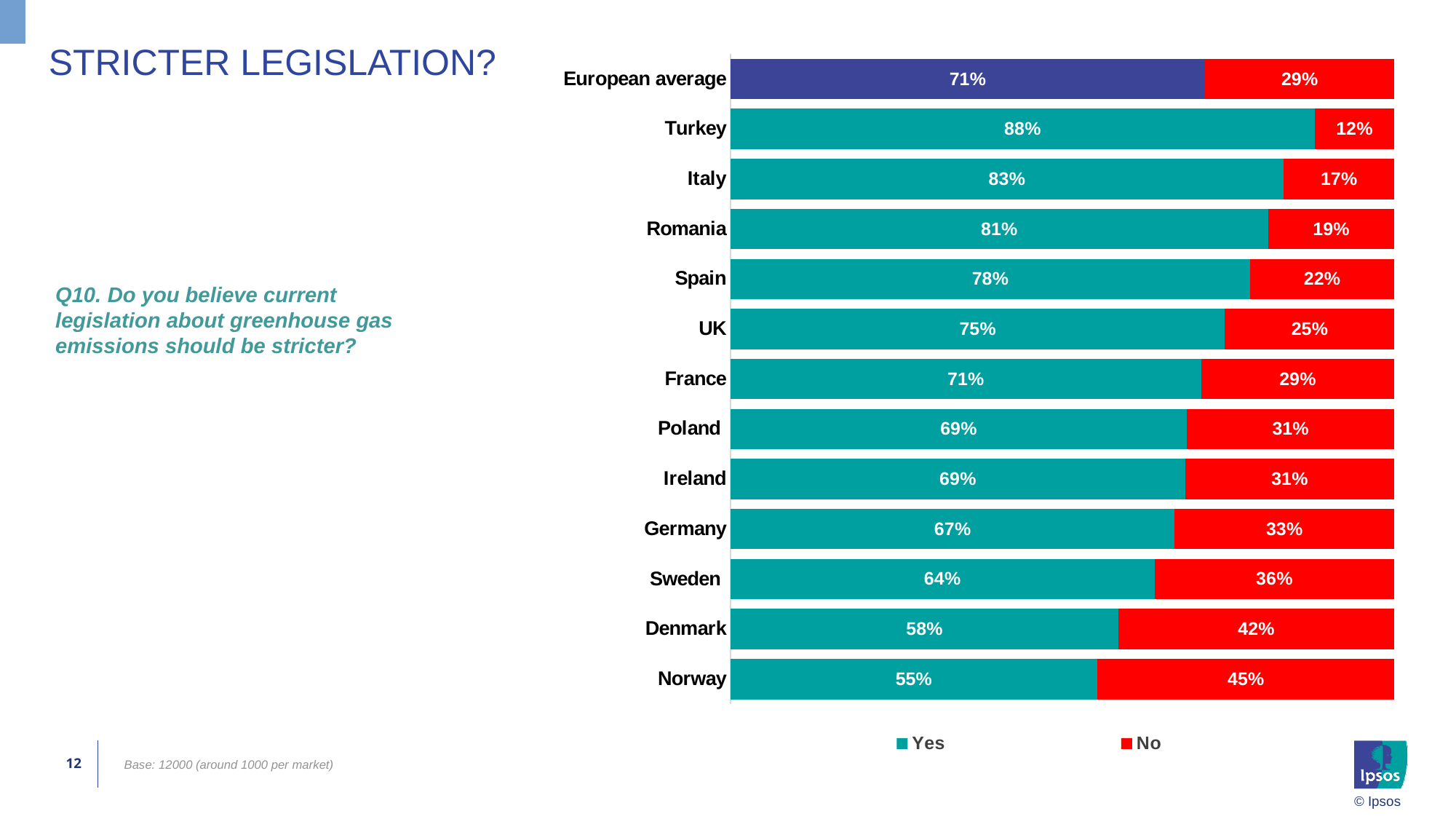
Which country has the highest Yes percentage? Turkey Which country has the lowest Yes percentage? Norway What percentage of respondents in Turkey answered Yes? 88% What kind of chart is shown on the slide? Stacked bar chart Which has a larger No value, Sweden or Spain? Sweden How many series does the legend list? 2 What is the difference between the Yes values for Italy and Germany? 16% What is the Yes value for the European average? 71% What is the total of the Yes and No values for Norway? 100% How many categories (rows) are shown in the chart, including the European average? 13 What is the No value for Denmark? 42% What colour represents the No series in the legend? Red